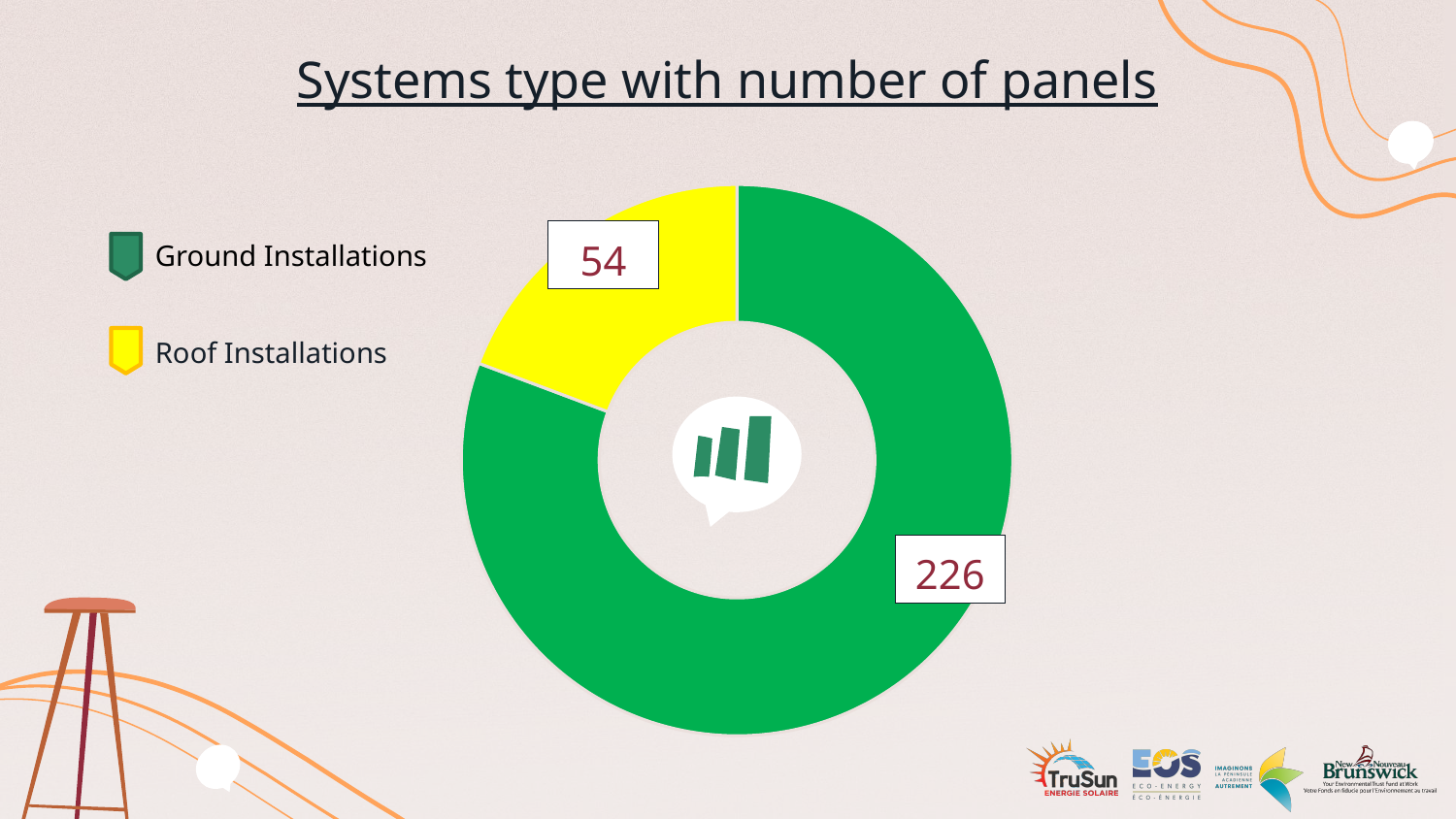
Is the number of panels for Ground Installations greater or less than 200? greater Which has more panels, Roof Installations or Ground Installations? Ground Installations Which system type has the fewest panels? Roof Installations What kind of chart is shown on the slide? doughnut chart How many system types are shown in the chart? 2 How many panels are in Roof Installations? 54 Which system type has the most panels? Ground Installations What colour represents Roof Installations in the chart? yellow What is the difference in number of panels between Ground Installations and Roof Installations? 172 What is the title of the slide? Systems type with number of panels How many panels are in Ground Installations? 226 What is the total number of panels across both system types? 280